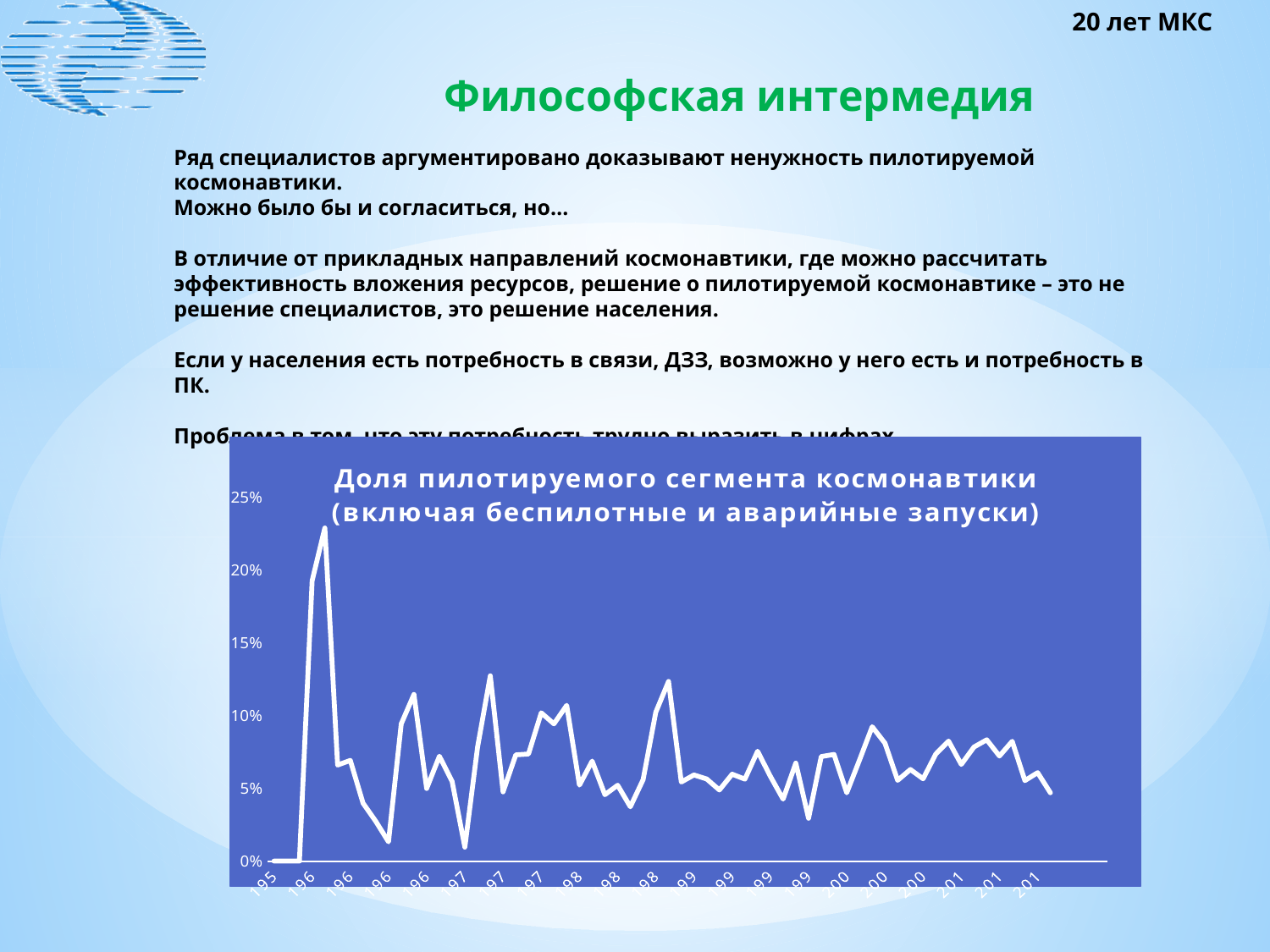
What is the title of the chart? Доля пилотируемого сегмента космонавтики (включая беспилотные и аварийные запуски) Is the peak value of the line larger than the final value at the right end? yes Is the peak value of the line greater or less than 20%? greater Is the value at the very start of the line (left end) greater or less than 5%? less After reaching its peak near the left side, does the line overall rise or fall toward the right end of the x axis? fall Is the peak value of the line greater or less than 25%? less What kind of chart is shown on the slide? line chart What is the highest tick value shown on the vertical axis of the chart? 25%